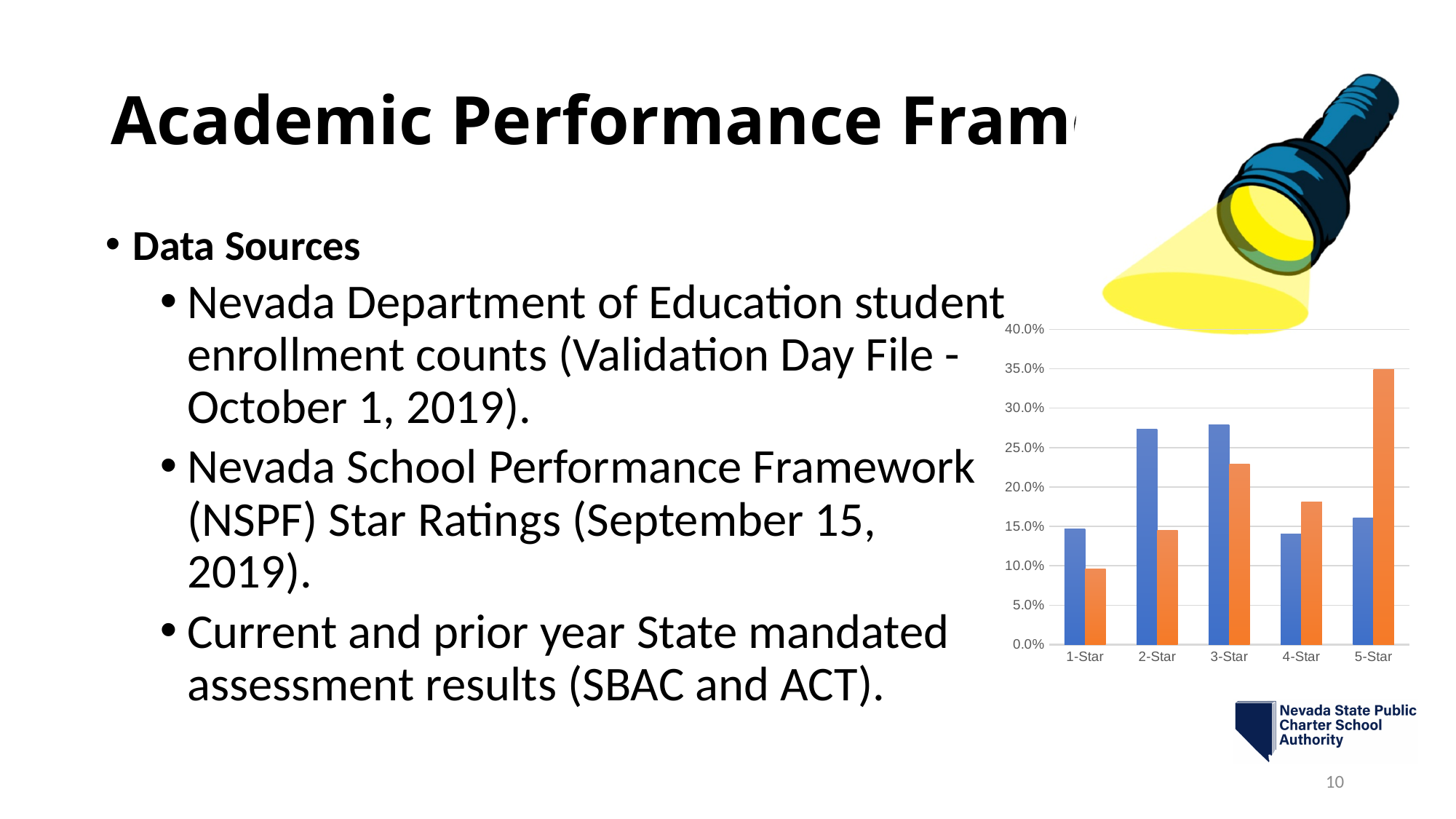
Is the orange bar for 5-Star greater or less than 30.0%? greater Is the orange bar for 3-Star greater or less than 20.0%? greater For the 1-Star category, which bar is taller, the blue one or the orange one? blue How many bars are plotted for each star-rating category in the chart? 2 Which category has the tallest orange bar in the chart? 5-Star What kind of chart is shown on the right side of the slide? bar chart For the 5-Star category, which bar is taller, the blue one or the orange one? orange How many categories are shown on the x axis of the chart? 5 Which category has the shortest orange bar in the chart? 1-Star Is the blue bar for 2-Star greater or less than 25.0%? greater What is the highest value shown on the chart's y axis? 40.0%